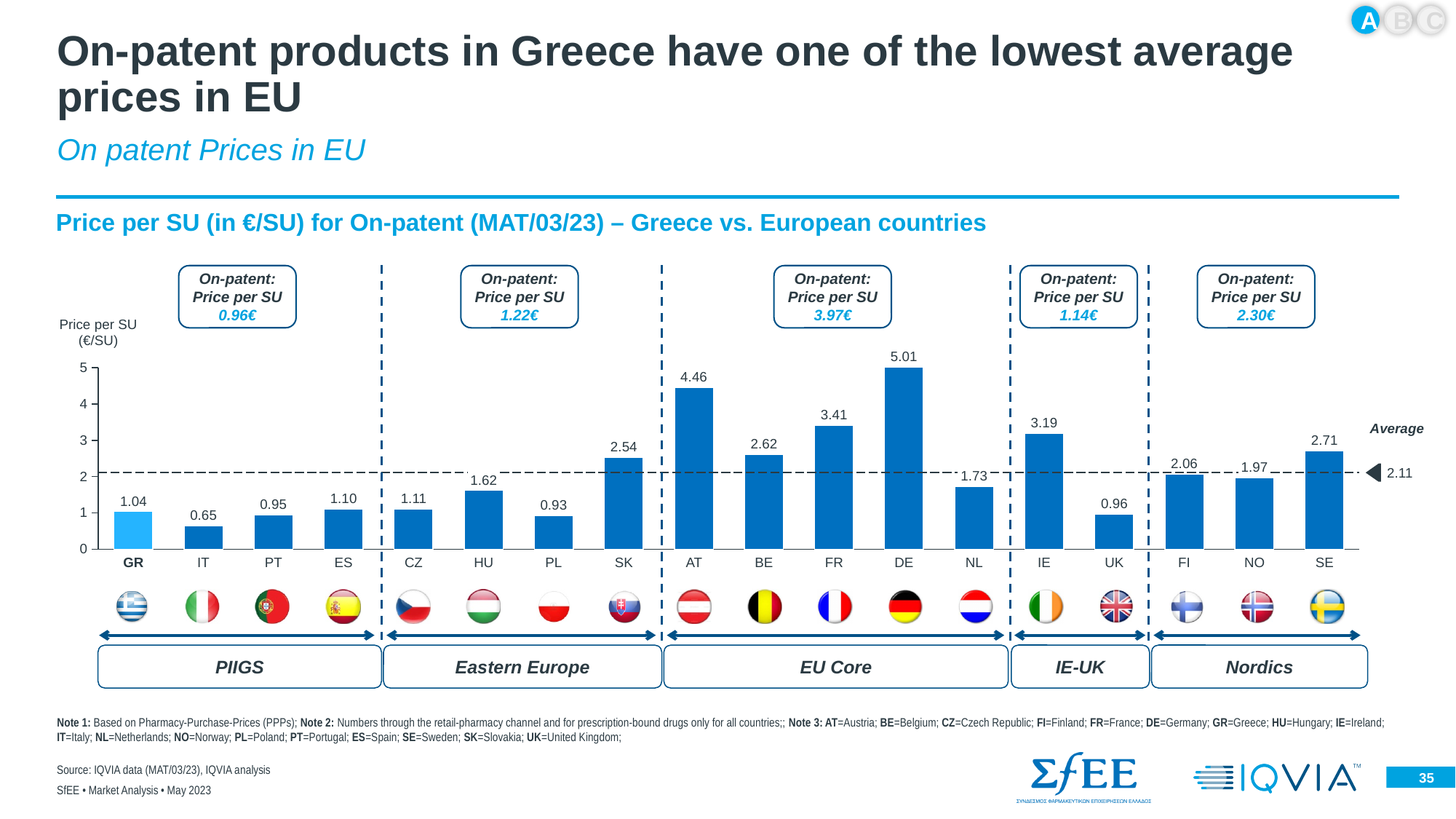
What is the price per SU for GR (Greece)? 1.04 What is the price per SU for SK (Slovakia)? 2.54 Which country has the lowest price per SU? IT What is the on-patent price per SU shown for the EU Core group? 3.97€ Which country has the highest price per SU? DE What is the average price per SU marked by the dashed line? 2.11 Which has a higher price per SU, IE or FR? FR What kind of chart is shown on the slide? Bar chart What is the price per SU for DE (Germany)? 5.01 How many country groups are labelled below the chart? 5 How many countries are shown on the chart? 18 What is the difference in price per SU between AT and BE? 1.84